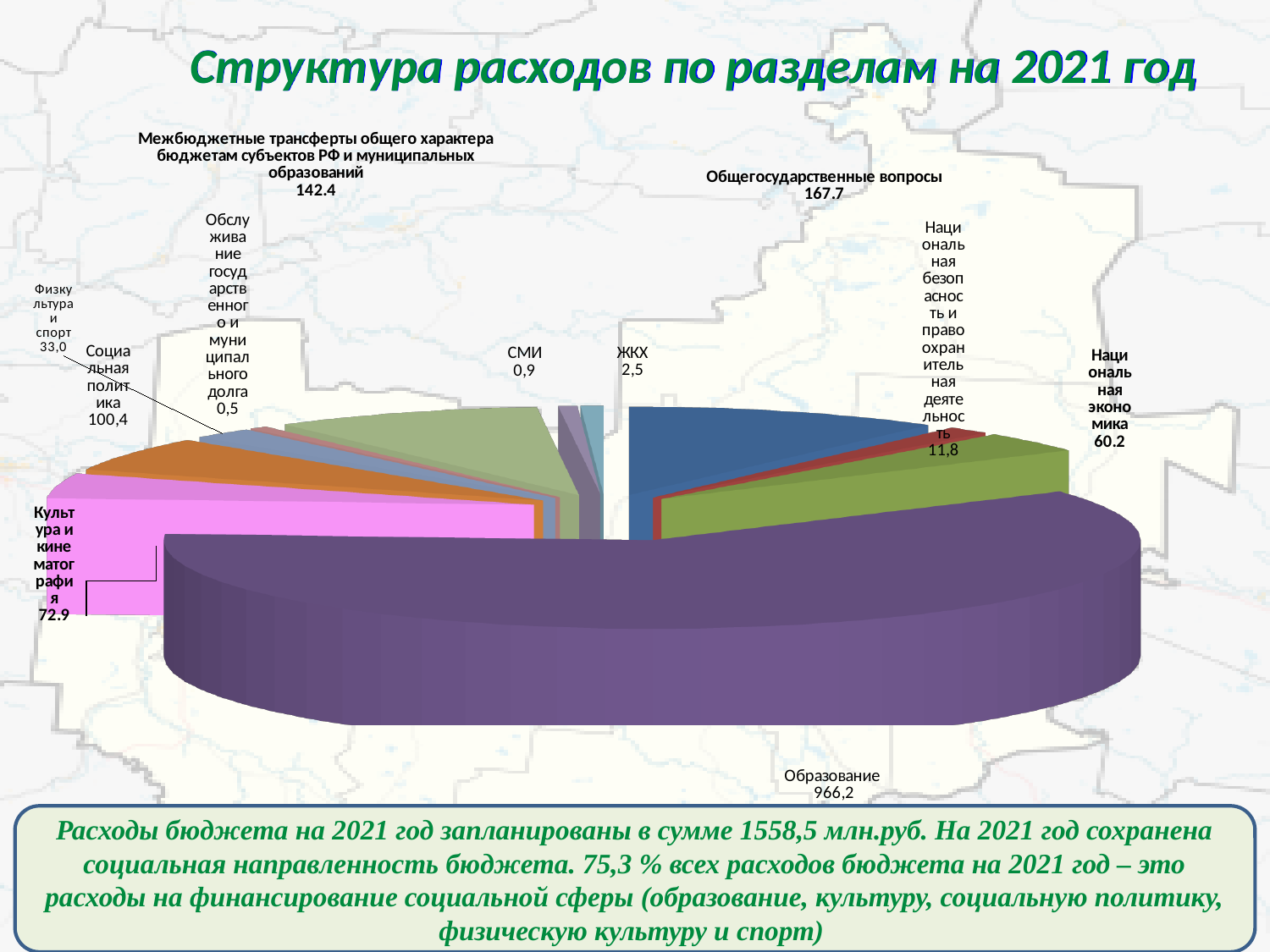
What kind of chart is shown on the slide? Pie chart Which is larger: Социальная политика or Культура и кинематография? Социальная политика What is the value for Социальная политика? 100,4 Which section has the smallest value? Обслуживание государственного и муниципального долга What is the value for Образование? 966,2 How many sections (slices) are shown in the pie chart? 11 What is the value for Общегосударственные вопросы? 167.7 What is the difference between Общегосударственные вопросы and Межбюджетные трансферты общего характера бюджетам субъектов РФ и муниципальных образований? 25.3 What is the value for ЖКХ? 2,5 What is the value for Национальная экономика? 60.2 Which section has the largest share of expenditures? Образование What is the title of the chart? Структура расходов по разделам на 2021 год